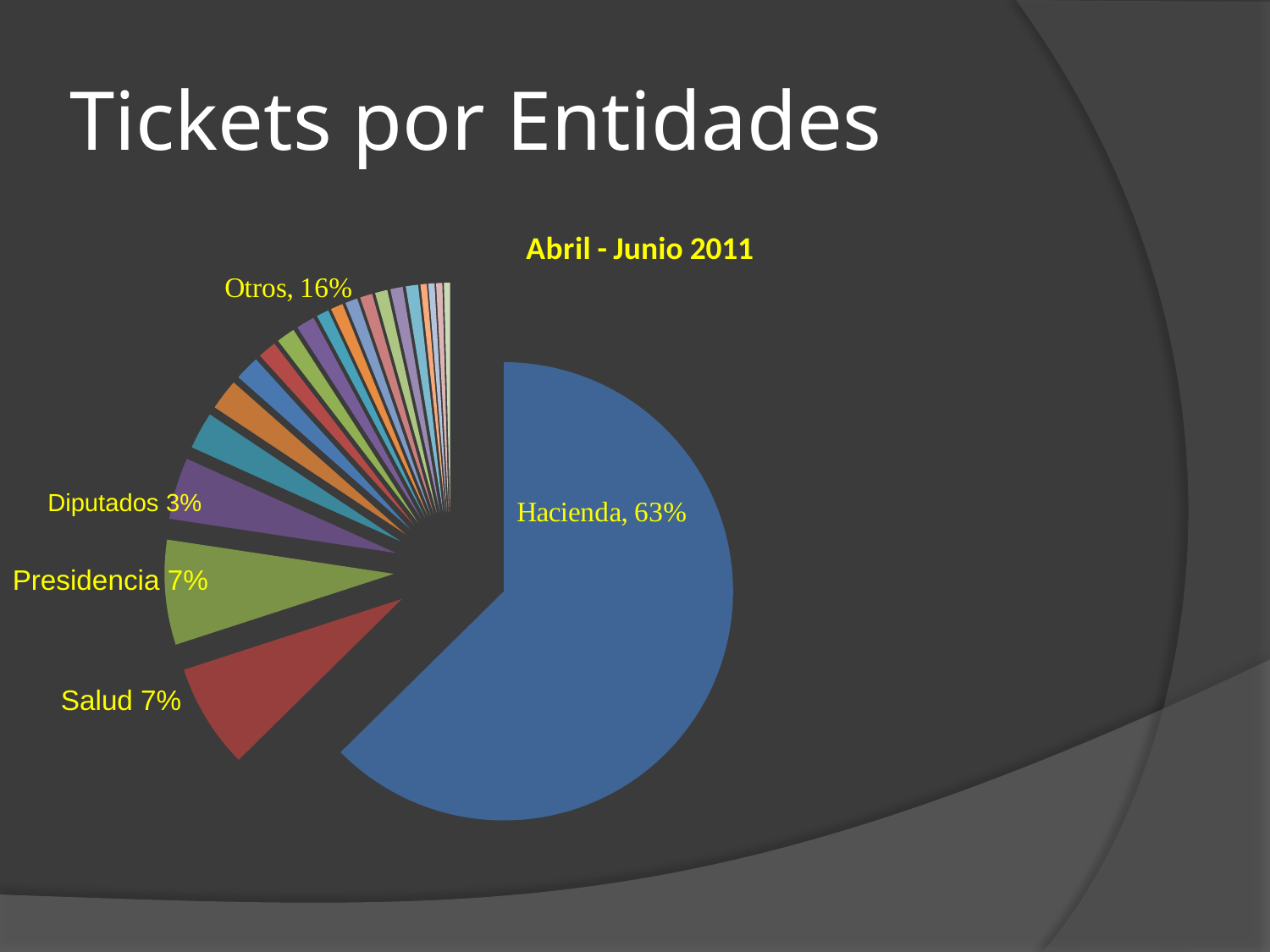
Which labelled entity has the largest share of tickets? Hacienda Which is larger, the share for Otros or the share for Salud? Otros What percentage is shown for Presidencia? 7% How many percentage points larger is Salud's share than Diputados' share? 4 How many percentage points larger is Hacienda's share than Otros' share? 47 What type of chart is shown on the slide? pie chart What percentage is shown for Salud? 7% What percentage is shown for Diputados? 3% Which labelled entity has the smallest share of tickets? Diputados What share of tickets does Hacienda account for? 63% What percentage is shown for Otros? 16% What is the title of the chart? Abril - Junio 2011